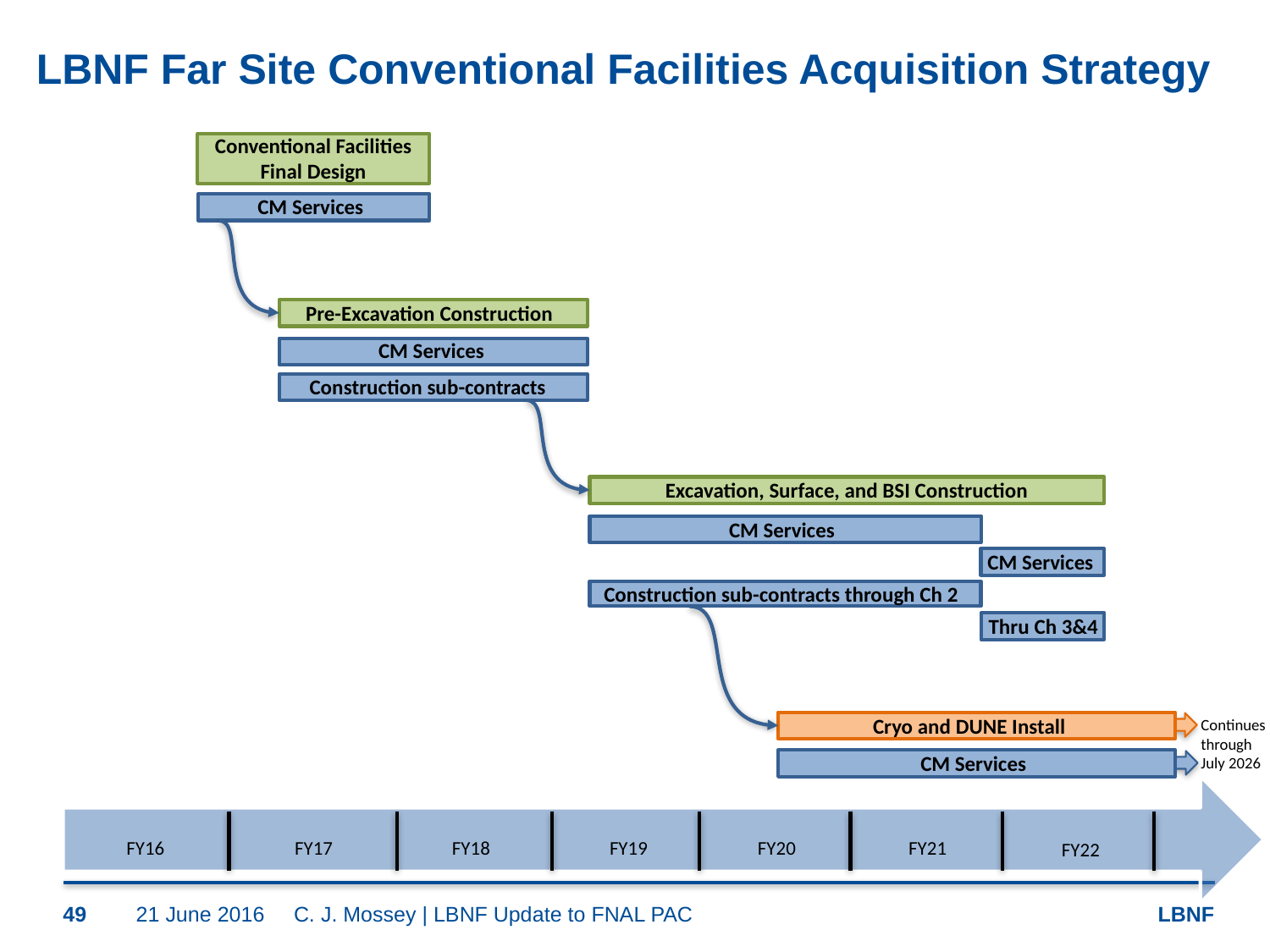
How many fiscal years are labelled on the timeline axis at the bottom of the slide? 7 What is the first fiscal year labelled on the timeline axis? FY16 How many bars labelled "CM Services" appear on the chart? 5 Which phase bar on the chart is coloured orange? Cryo and DUNE Install How many green phase bars are shown on the chart? 3 What kind of chart is shown on the slide? Gantt-style timeline chart What does the text at the right end of the "Cryo and DUNE Install" bar say? Continues through July 2026 What is the last fiscal year labelled on the timeline axis? FY22